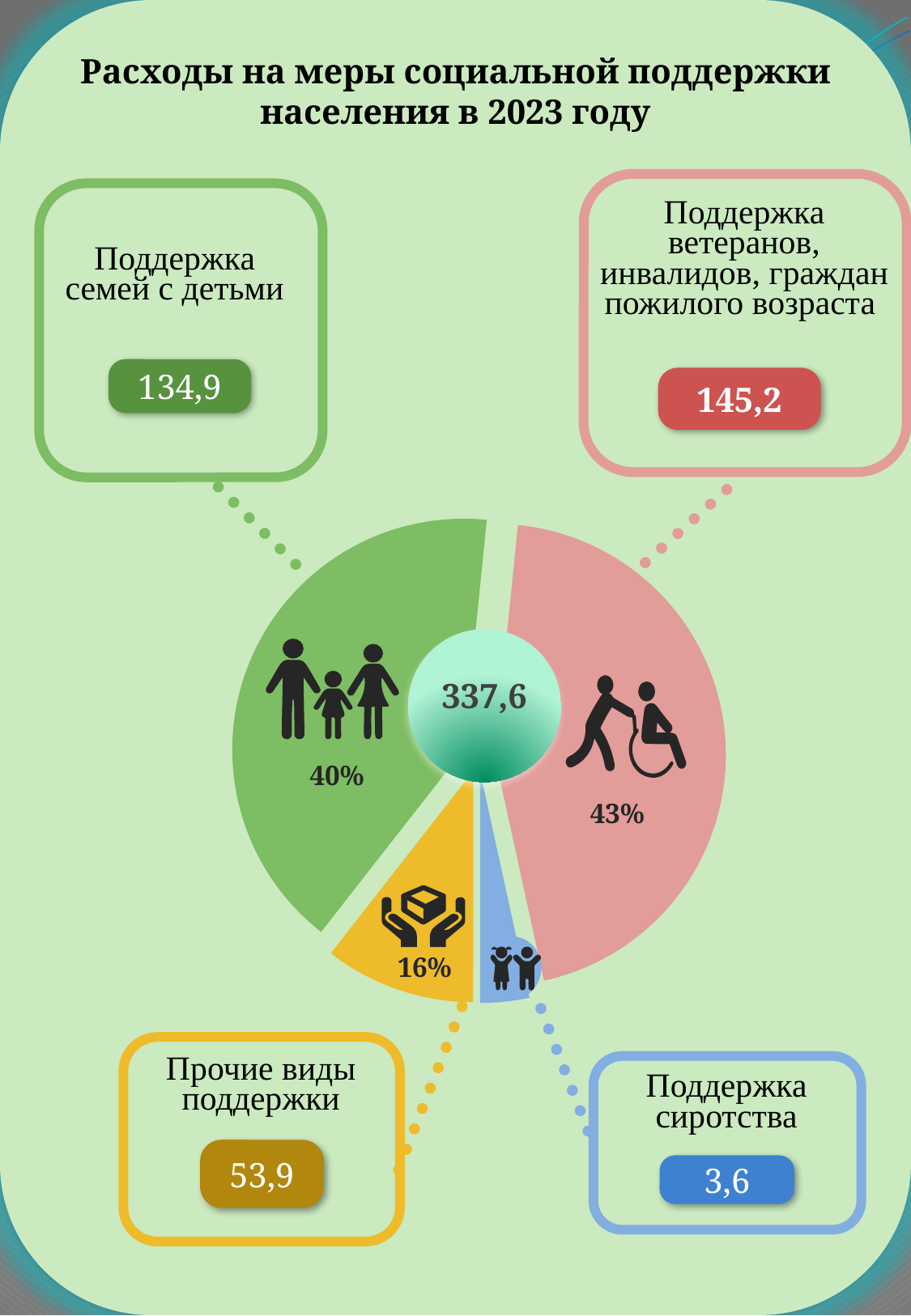
What total value is shown in the centre of the pie chart? 337,6 Which category has the lowest value? Поддержка сиротства How many slices does the pie chart have? 4 What is the difference between the values for «Поддержка ветеранов, инвалидов, граждан пожилого возраста» and «Поддержка семей с детьми»? 10,3 What kind of chart is shown on the slide? pie chart What is the value for «Прочие виды поддержки»? 53,9 What share of the pie does «Поддержка семей с детьми» represent? 40% What is the value for «Поддержка семей с детьми»? 134,9 What is the value for «Поддержка сиротства»? 3,6 Which is larger: the value for «Поддержка семей с детьми» or for «Прочие виды поддержки»? Поддержка семей с детьми What is the value for «Поддержка ветеранов, инвалидов, граждан пожилого возраста»? 145,2 Which category has the highest value? Поддержка ветеранов, инвалидов, граждан пожилого возраста